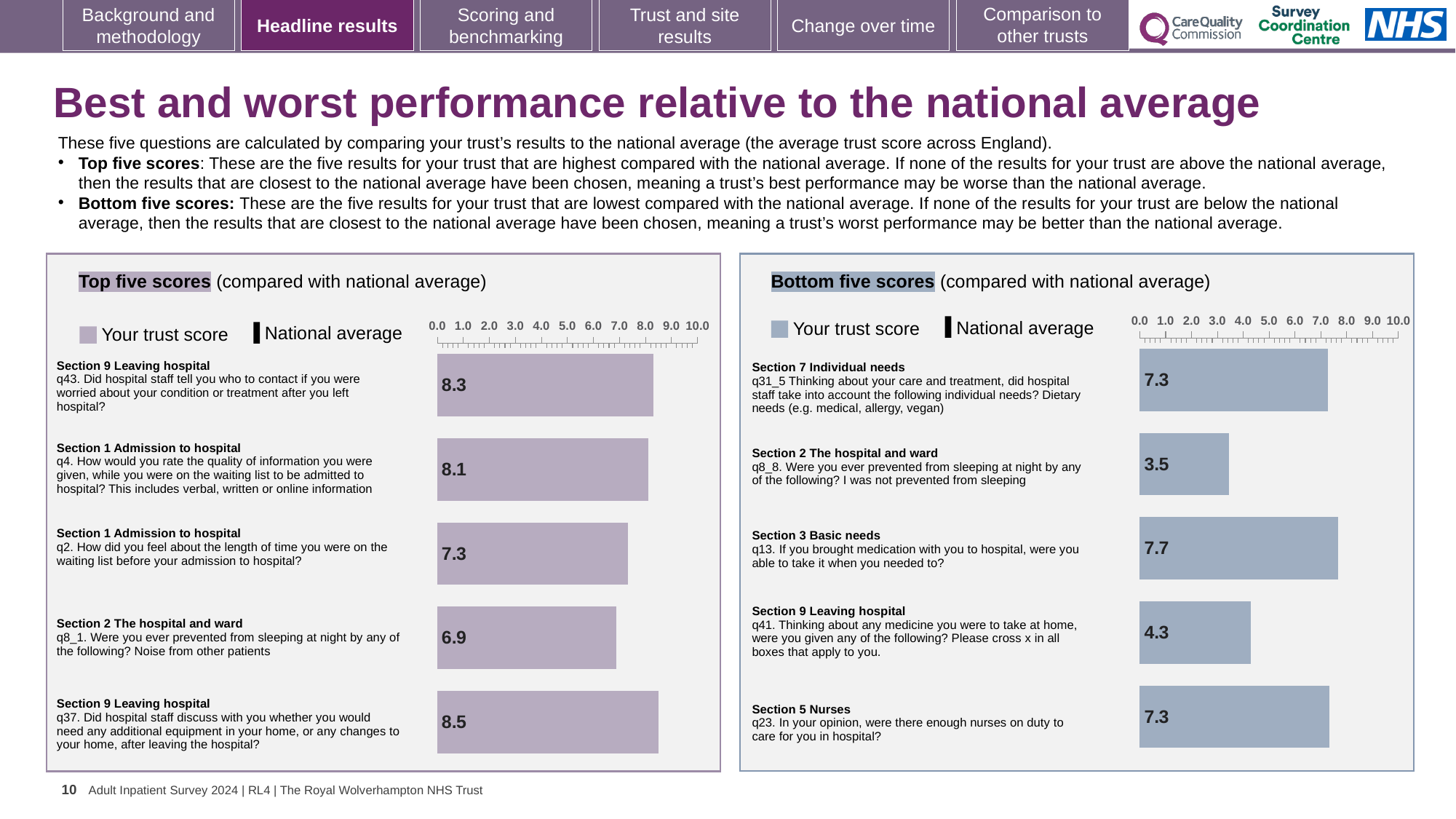
How many bars are plotted in the Bottom five scores chart? 5 In the Top five scores chart, what is the difference between the trust scores for q37 and q2? 1.2 In the Top five scores chart, which question has the highest trust score? q37 What type of chart is used in the Top five scores panel? Bar chart In the Top five scores chart, what is the trust score for q8_1 (prevented from sleeping at night by noise from other patients)? 6.9 In the Bottom five scores chart, which question has the lowest trust score? q8_8 In the Top five scores chart, what is the trust score for q43 (Did hospital staff tell you who to contact if you were worried about your condition or treatment after you left hospital)? 8.3 In the Bottom five scores chart, which has the larger trust score, q41 or q23? q23 In the Bottom five scores chart, what is the trust score for q8_8 (I was not prevented from sleeping)? 3.5 In the Bottom five scores chart, which question has the highest trust score? q13 In the Top five scores chart, which question has the lowest trust score? q8_1 In the Bottom five scores chart, what is the trust score for q13 (able to take medication you brought with you when you needed to)? 7.7